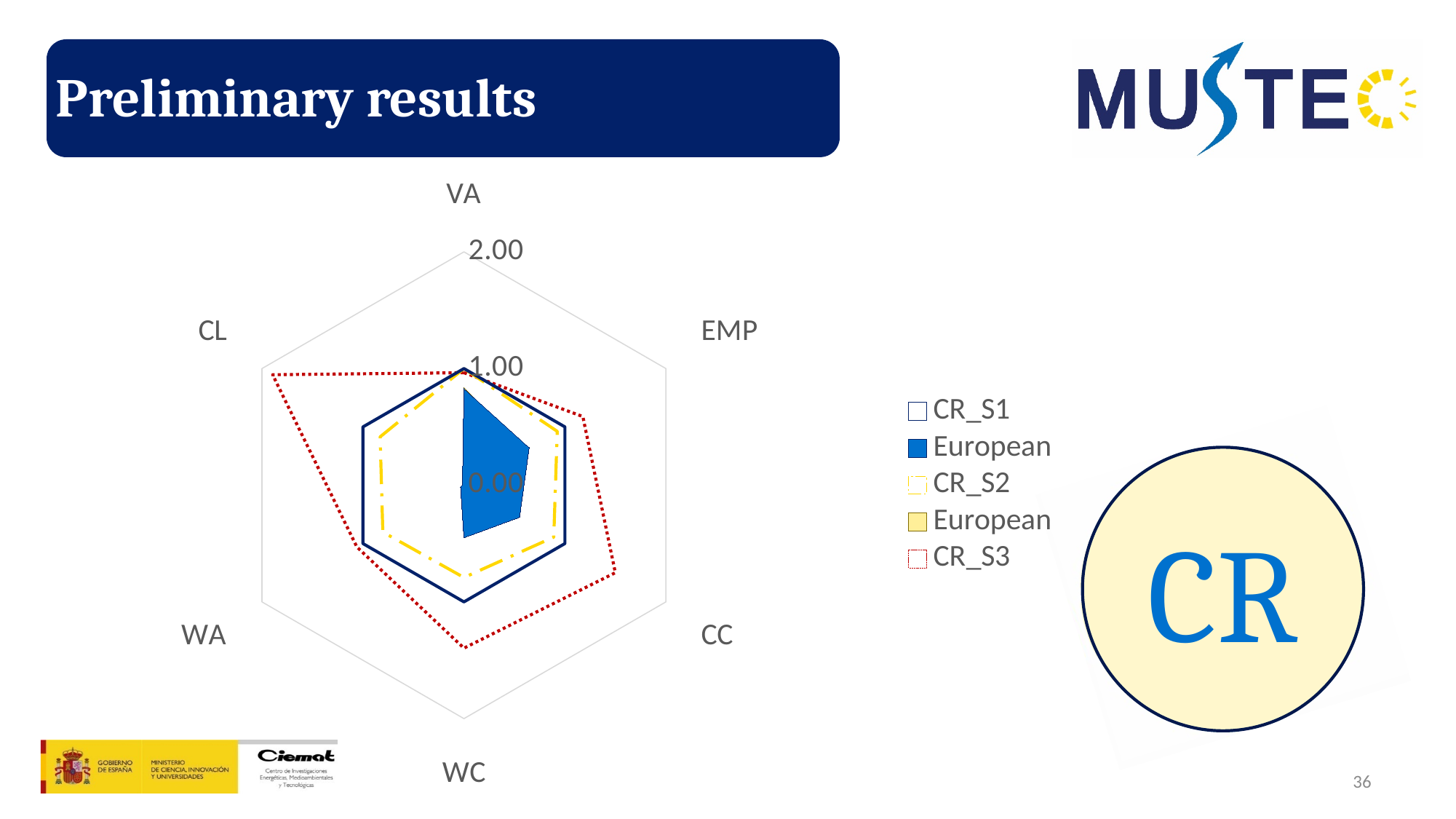
Is the value of CR_S3 for CL greater or less than 1.00? greater What is the highest value shown on the radar chart's axis scale? 2.00 Is the value of CR_S3 for CC greater or less than 1.00? greater What kind of chart is shown on the slide? radar chart How many axes (categories) does the radar chart have? 6 For CC, which is larger: CR_S3 or the European series? CR_S3 On which axis does CR_S3 reach its highest value? CL Is the value of the European series for CC greater or less than 1.00? less What is the title of the slide containing the radar chart? Preliminary results How many series does the legend list? 5